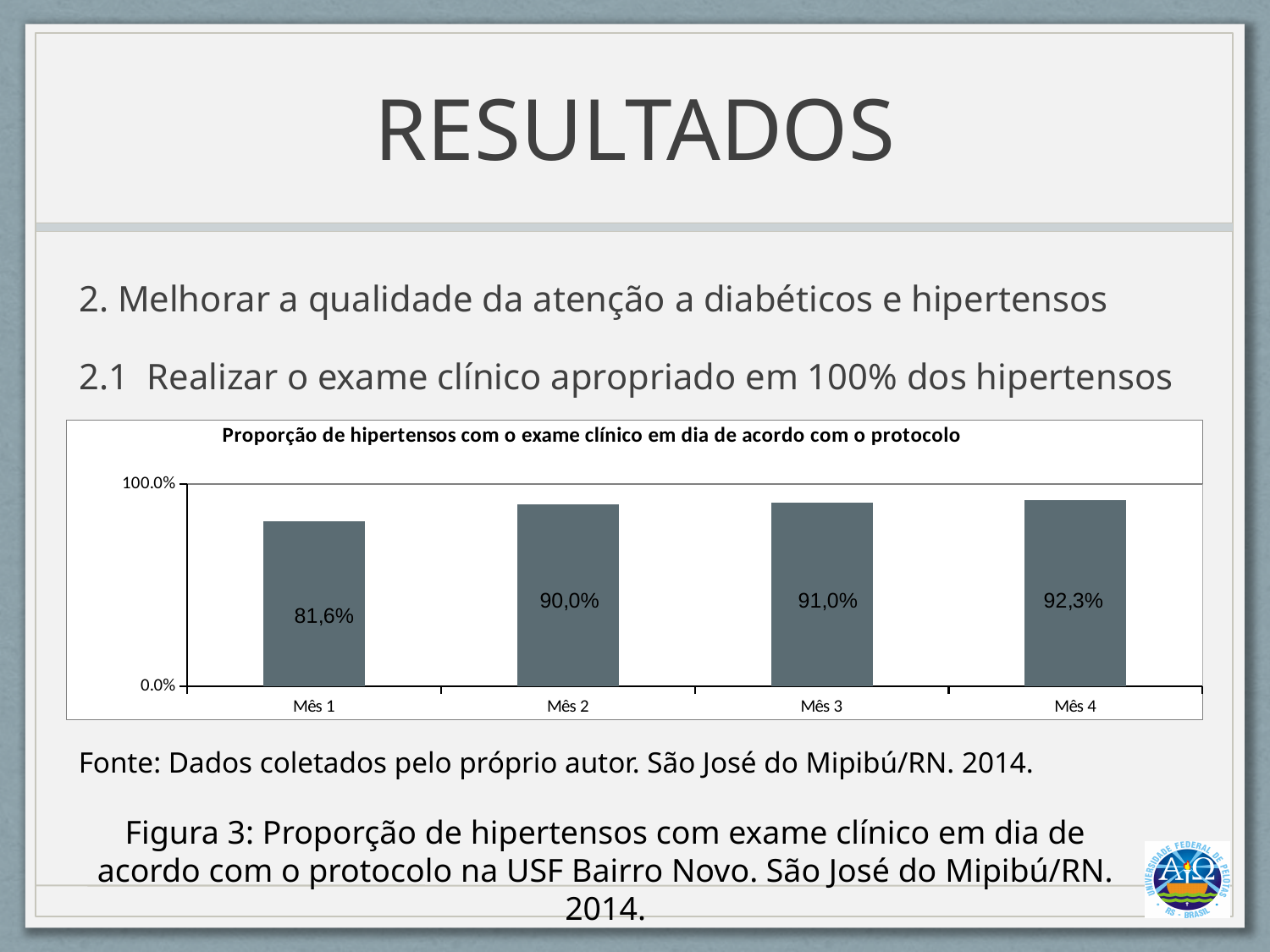
Which month has the highest proportion? Mês 4 What kind of chart is shown on the slide? bar chart What is the difference between the values for Mês 2 and Mês 1? 8,4 percentage points Which month has the lowest proportion? Mês 1 What is the value for Mês 4? 92,3% Which is larger, the value for Mês 2 or the value for Mês 4? Mês 4 What is the value for Mês 3? 91,0% What is the difference between the values for Mês 4 and Mês 1? 10,7 percentage points How many months are shown on the x axis? 4 Is the value for Mês 1 greater or less than 100.0%? less Do the values rise or fall from Mês 1 to Mês 4? rise What is the value for Mês 1? 81,6%